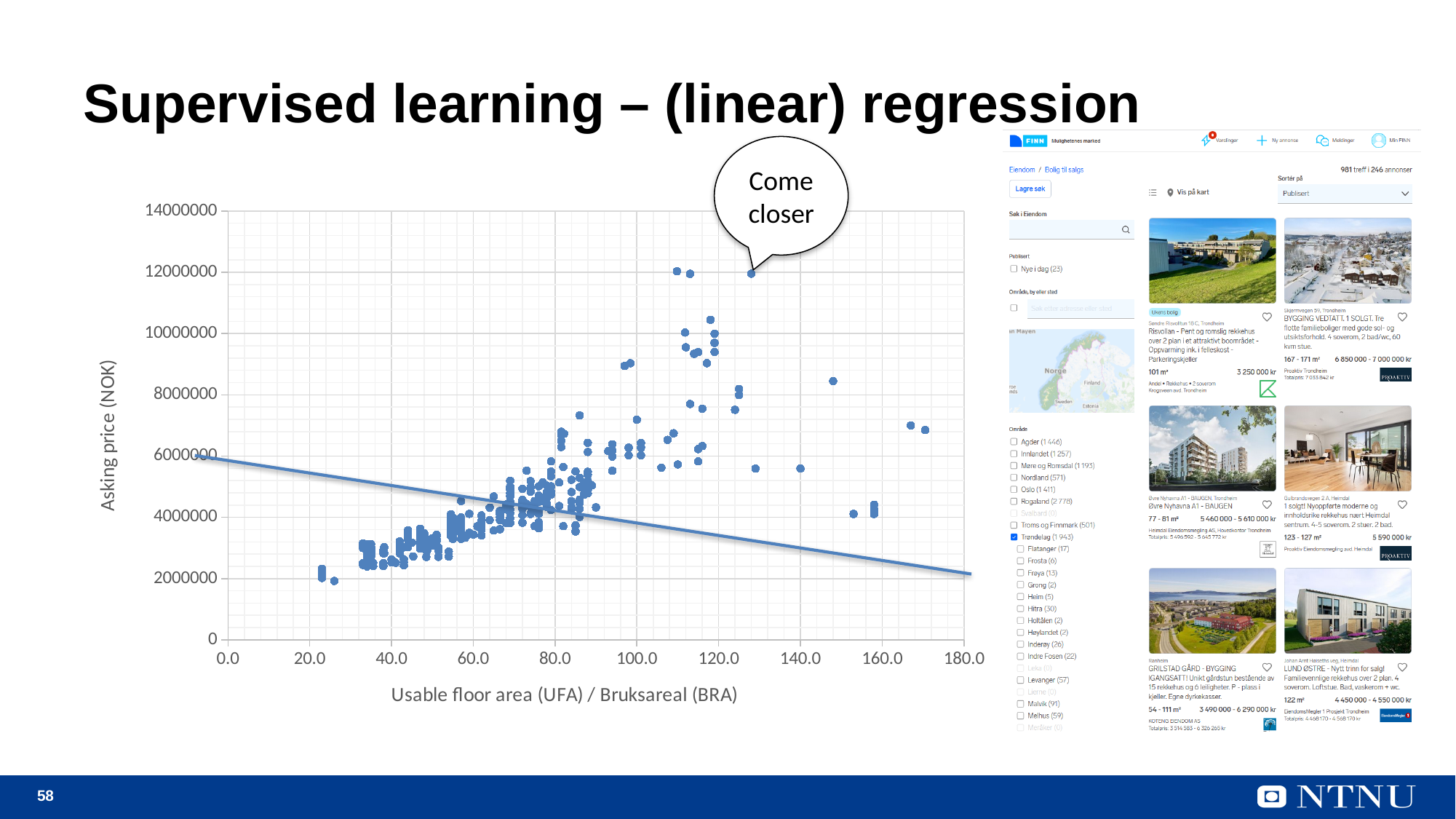
Is the asking price of the highest plotted point greater or less than 10000000? greater Is the asking price of the lowest plotted point greater or less than 4000000? less Is the value of the fitted line at a usable floor area of 180.0 greater or less than 4000000? less Does the straight fitted line in the chart rise or fall as the x axis increases? fall Do the plotted asking prices generally rise or fall as usable floor area increases? rise What is the label of the x axis of the chart? Usable floor area (UFA) / Bruksareal (BRA) What is the highest tick value shown on the y axis? 14000000 What is the label of the y axis of the chart? Asking price (NOK) What kind of chart is shown on the slide? scatter chart